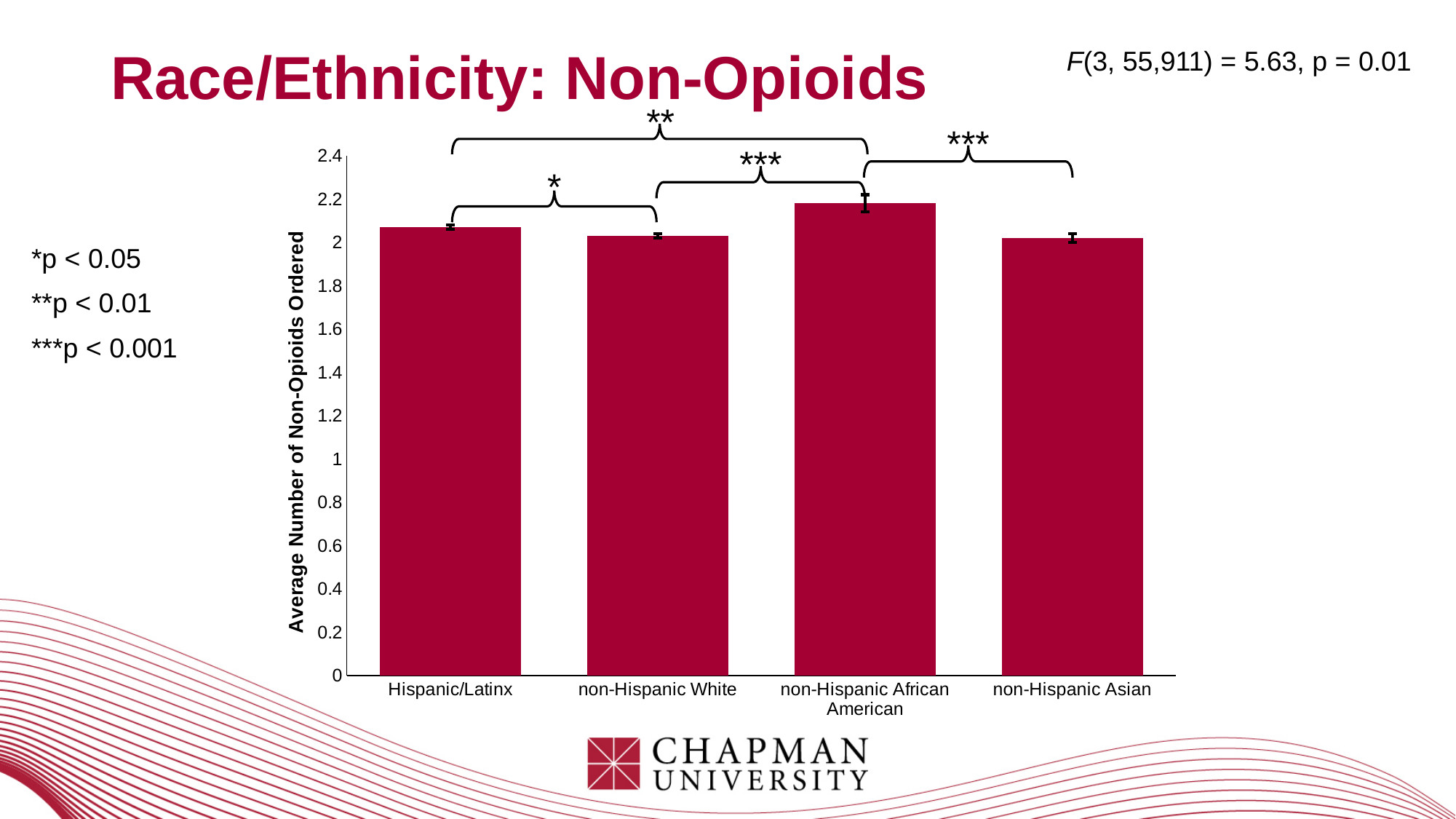
Which is larger, the value for non-Hispanic African American or the value for non-Hispanic Asian? non-Hispanic African American What is the title of the slide? Race/Ethnicity: Non-Opioids Is the value for Hispanic/Latinx greater or less than 2? greater What kind of chart is shown on the slide? bar chart Is the value for non-Hispanic Asian greater or less than 2.2? less Which category has the highest average number of non-opioids ordered? non-Hispanic African American What is the title of the y-axis? Average Number of Non-Opioids Ordered Is the value for non-Hispanic White greater or less than 2.2? less Which is larger, the value for non-Hispanic African American or the value for non-Hispanic White? non-Hispanic African American How many race/ethnicity categories are plotted in the chart? 4